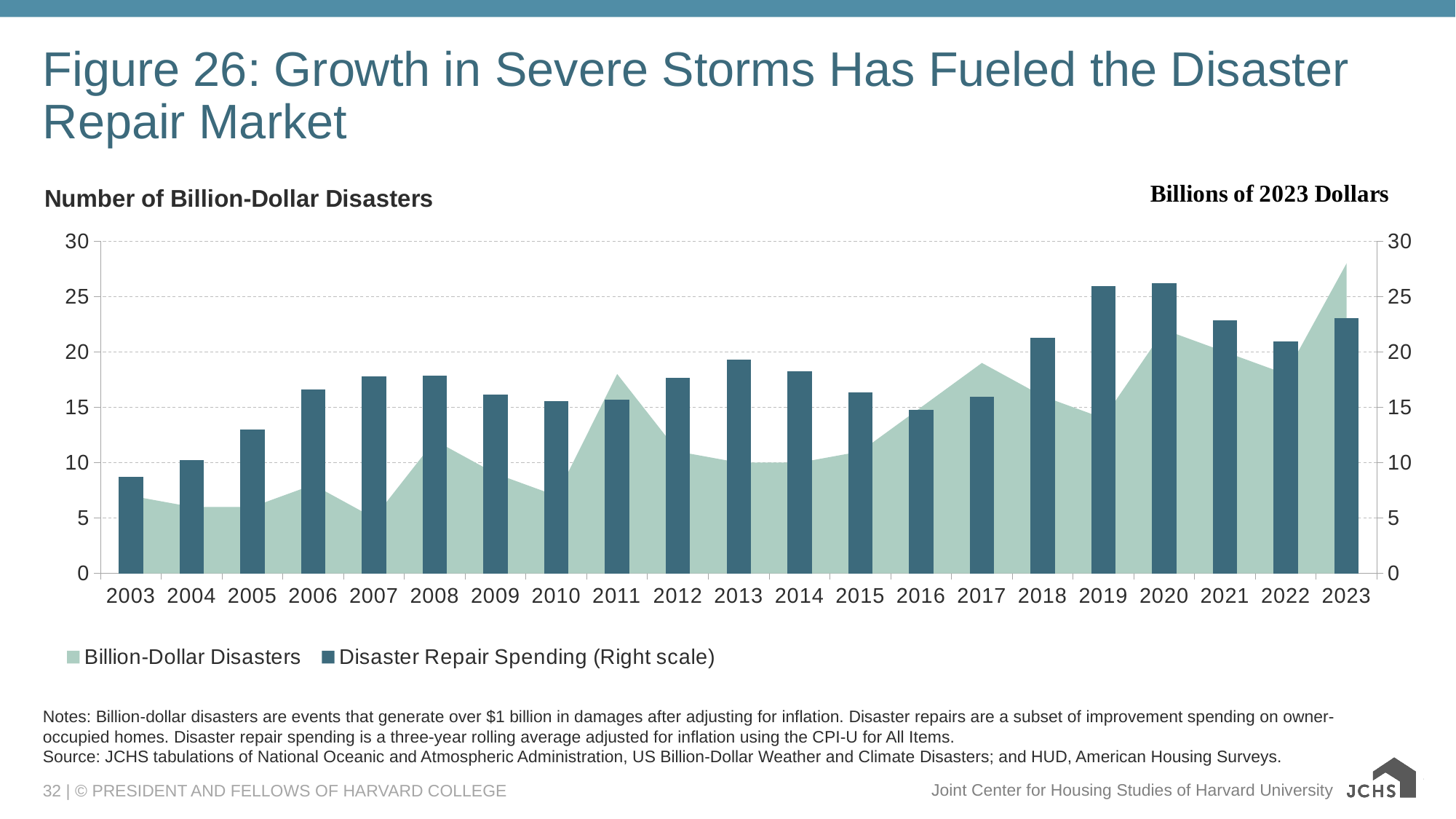
Which year has higher Disaster Repair Spending, 2013 or 2016? 2013 What kind of chart is used to show Disaster Repair Spending? Bar chart What is the label of the right-hand axis? Billions of 2023 Dollars How many series does the legend list? 2 Which year has the lowest Disaster Repair Spending? 2003 Is the Disaster Repair Spending value for 2003 greater or less than 10? less Which year has the highest number of Billion-Dollar Disasters? 2023 How many years are shown on the x axis? 21 Is the Disaster Repair Spending value for 2019 greater or less than 25? greater Is the number of Billion-Dollar Disasters in 2023 greater or less than 25? greater Does Disaster Repair Spending rise or fall from 2003 to 2008? rise